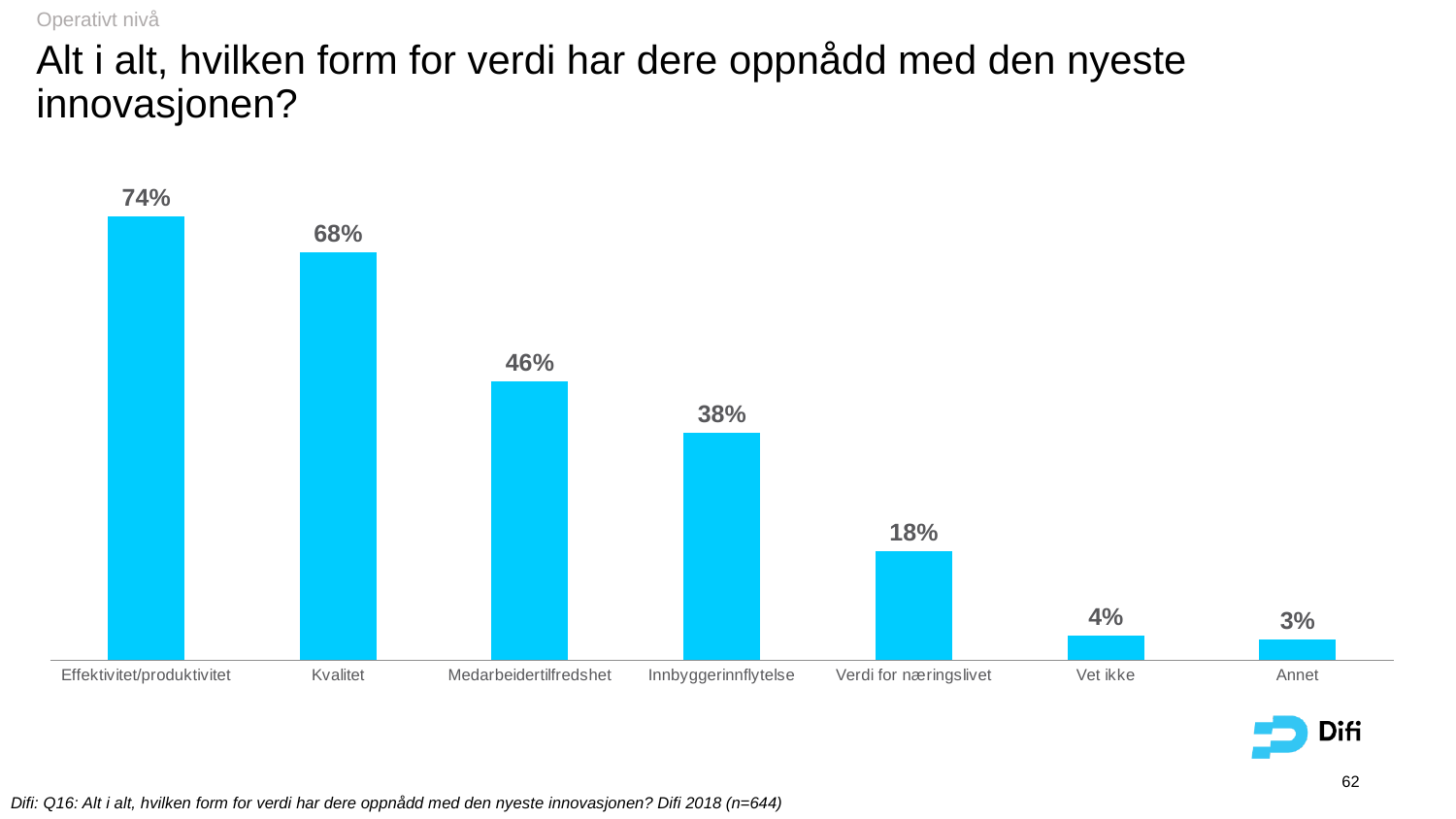
How many categories are shown in the chart? 7 Which is larger, the value for Medarbeidertilfredshet or the value for Innbyggerinnflytelse? Medarbeidertilfredshet What is the value for Verdi for næringslivet? 18% Which category has the lowest value? Annet What is the difference between the values for Kvalitet and Innbyggerinnflytelse? 30% Which category has the highest value? Effektivitet/produktivitet What is the difference between the values for Effektivitet/produktivitet and Kvalitet? 6% Do the values rise or fall from left to right along the x axis? Fall What is the value for Medarbeidertilfredshet? 46% What kind of chart is shown on the slide? Bar chart What is the value for Vet ikke? 4% What is the value for Effektivitet/produktivitet? 74%